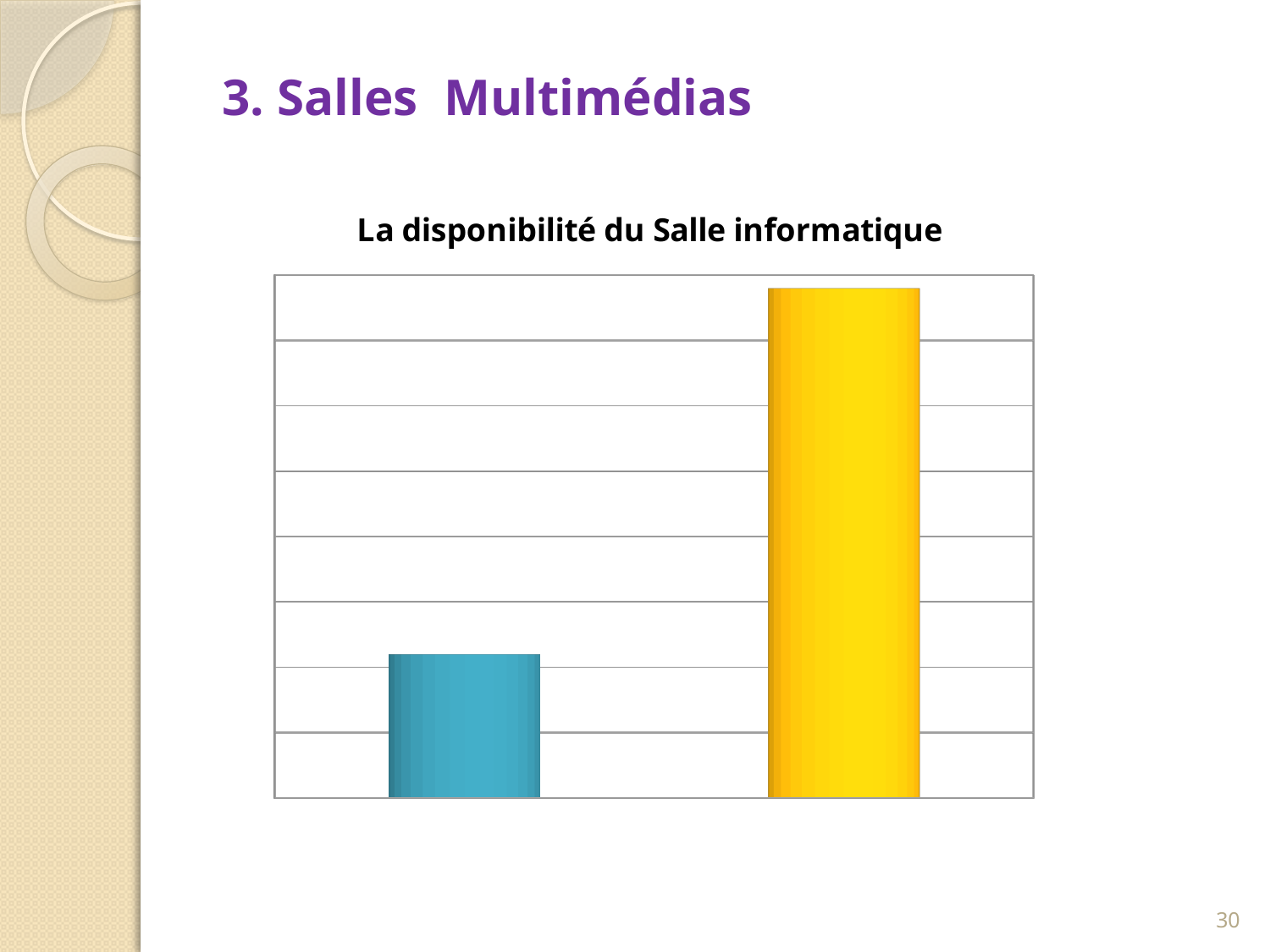
Which bar is taller, the blue bar on the left or the yellow bar on the right? the yellow bar on the right How many bars are plotted in the chart? 2 Which bar has the highest value, the left (blue) or the right (yellow)? the right (yellow) bar Do the bar values rise or fall from left to right? rise Which bar has the lowest value, the left (blue) or the right (yellow)? the left (blue) bar What kind of chart is shown on the slide? bar chart What colour is the left bar in the chart? blue What is the title of the chart? La disponibilité du Salle informatique